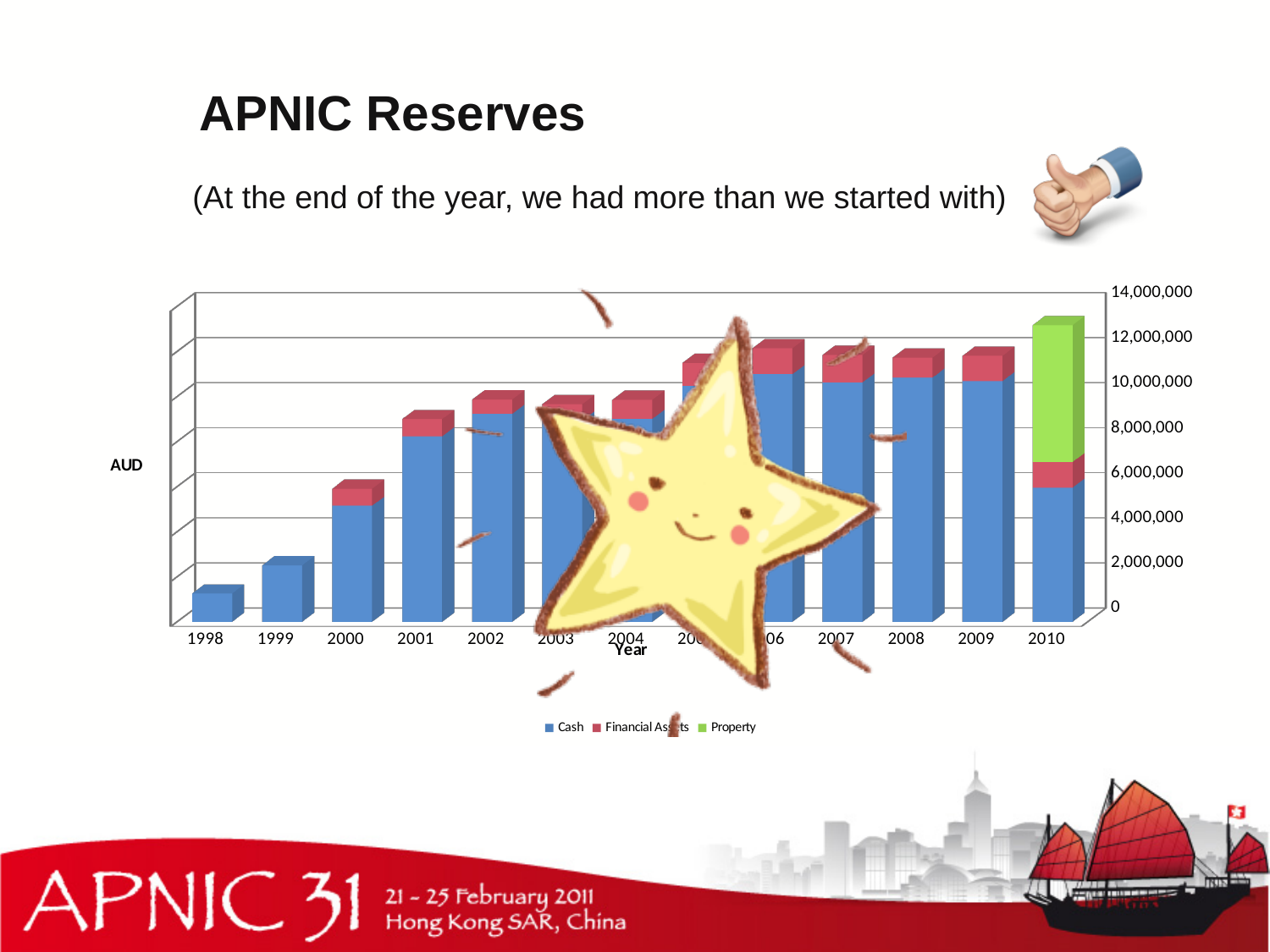
How many years are shown along the x axis? 13 What kind of chart is shown on the slide? Stacked bar chart Which is larger, the total for 2002 or the total for 2000? 2002 Do the total reserves generally rise or fall from 1998 to 2010? rise How many series does the legend list? 3 Which year has the lowest total reserves? 1998 Is the total value for 1998 greater or less than 2,000,000? less Is the total value for 2009 greater or less than 10,000,000? greater What label is shown on the vertical axis? AUD Is the total value for 2010 greater or less than 12,000,000? greater Which year has the highest total reserves? 2010